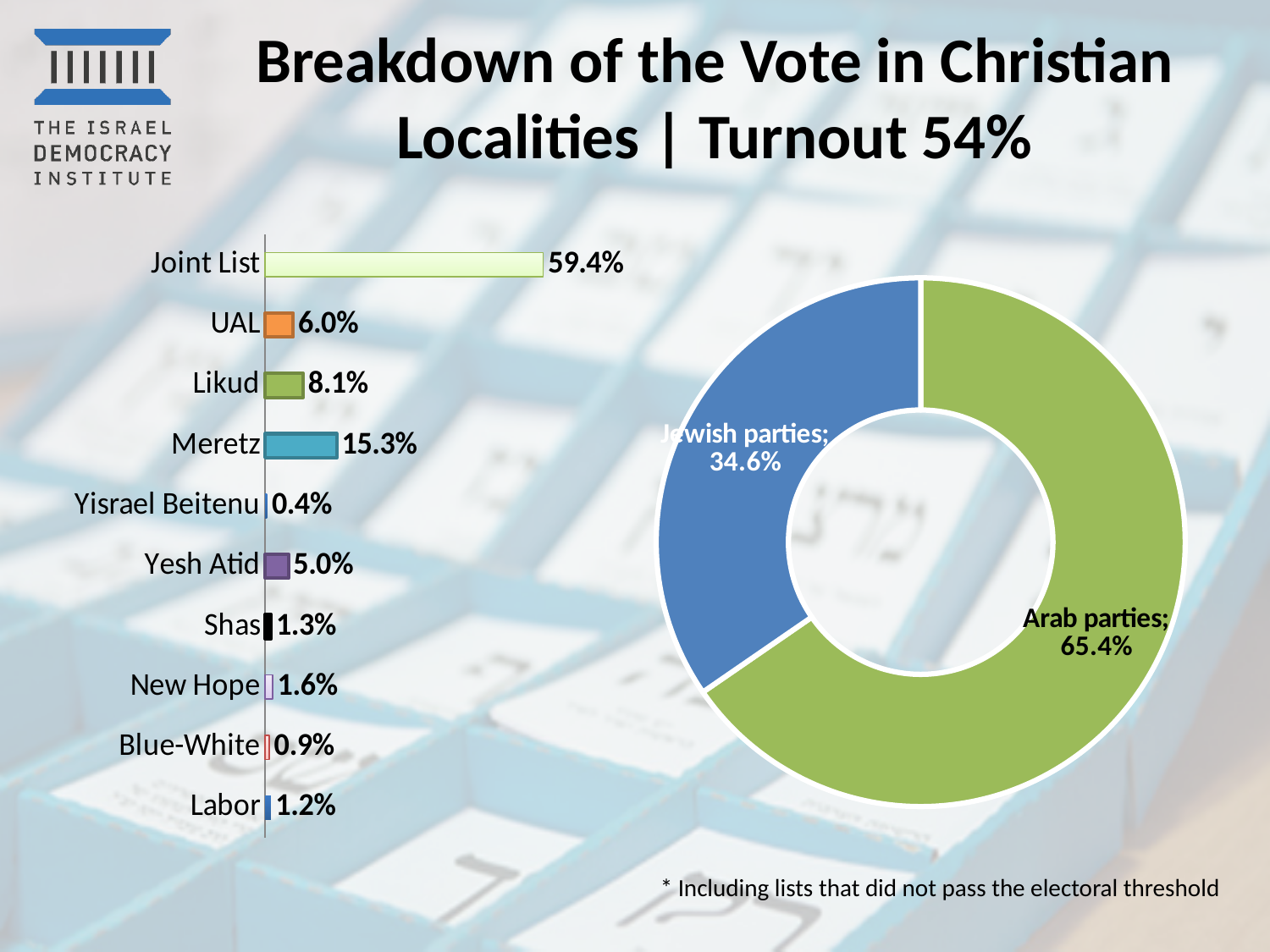
What turnout figure is given in the slide title? 54% In the doughnut chart on the right, which segment is larger, Arab parties or Jewish parties? Arab parties In the bar chart on the left, what percentage of the vote did the Joint List receive? 59.4% What kind of chart is shown on the left side of the slide? Bar chart How many parties are shown in the bar chart on the left? 10 In the doughnut chart on the right, what share of the vote went to Jewish parties? 34.6% In the bar chart on the left, which party has the highest share of the vote? Joint List In the bar chart on the left, which is larger, the value for UAL or the value for Yesh Atid? UAL In the bar chart on the left, what is the difference between the values for Meretz and Likud? 7.2% In the bar chart on the left, which party has the lowest share of the vote? Yisrael Beitenu In the bar chart on the left, what is the value for Meretz? 15.3% In the bar chart on the left, what is the value for Yisrael Beitenu? 0.4%